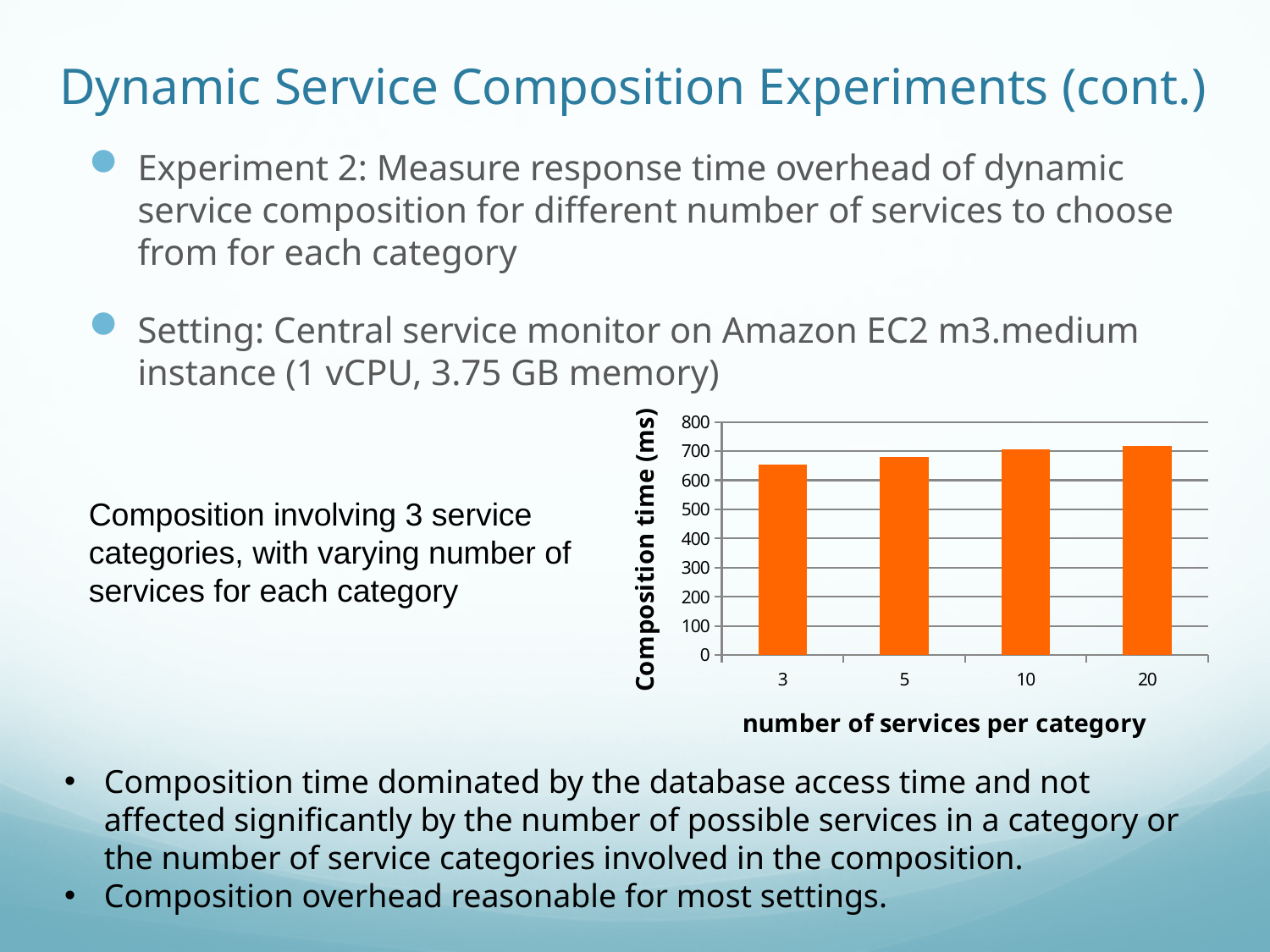
Which has a larger composition time: 3 services per category or 20 services per category? 20 Is the composition time for 3 services per category greater or less than 700? less Is the composition time for 5 services per category greater or less than 700? less What is the label of the x axis of the chart? number of services per category Which number of services per category has the lowest composition time? 3 Is the composition time for 3 services per category greater or less than 600? greater What is the label of the y axis of the chart? Composition time (ms) How many categories are plotted on the x axis of the chart? 4 What kind of chart is shown on the slide? bar chart Do the composition times rise or fall as the number of services per category increases along the x axis? rise